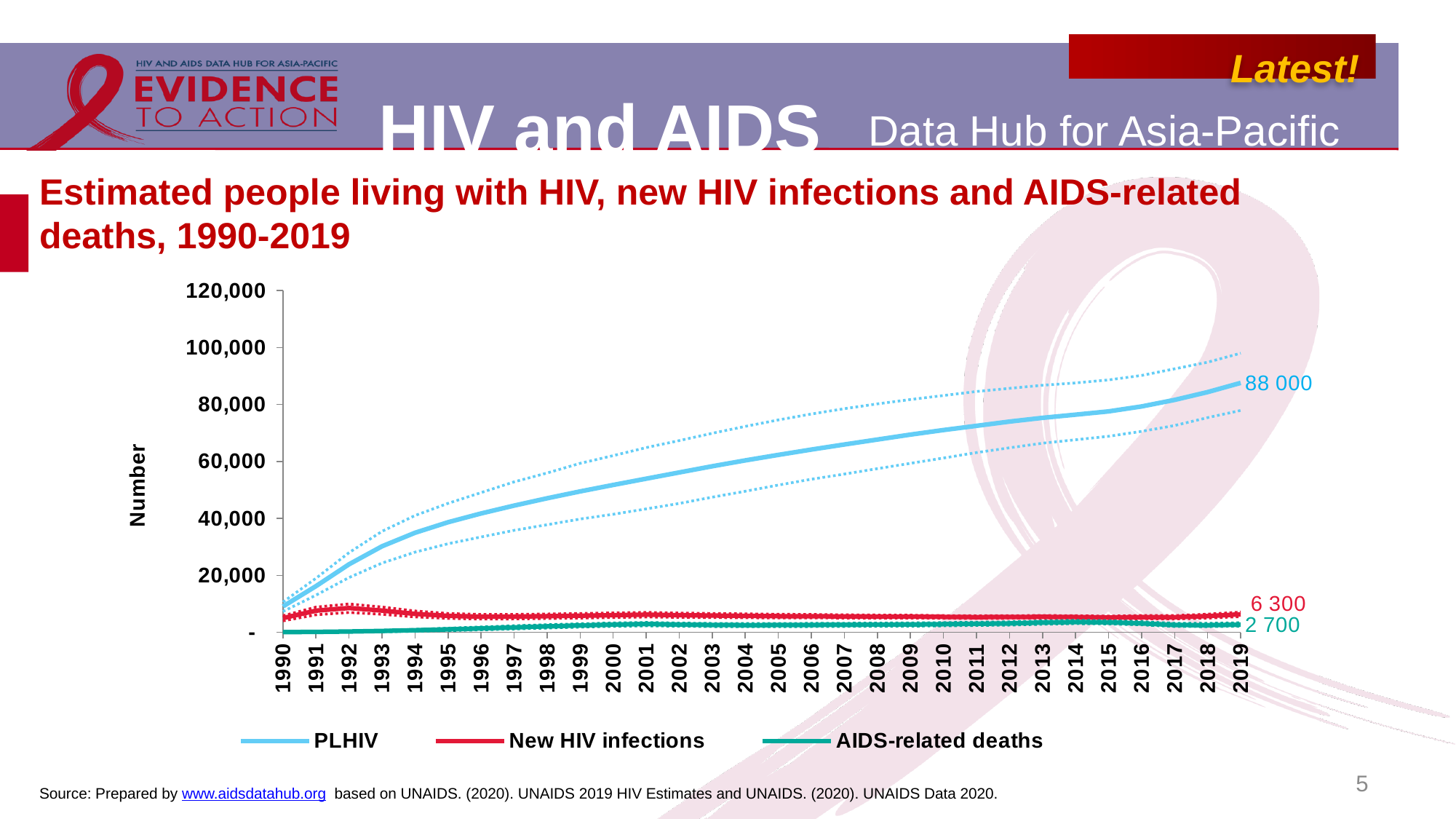
How many years are shown on the x axis? 30 What is the value for AIDS-related deaths in 2019? 2 700 What is the value for PLHIV in 2019? 88 000 Is the value for PLHIV in 1995 greater or less than 60,000? less What kind of chart is shown on the slide? line chart Is the value for PLHIV in 2000 greater or less than 40,000? greater Does the PLHIV line rise or fall from 1990 to 2019? rise Which series has the lowest value in 2019? AIDS-related deaths Which series has the highest value in 2019? PLHIV What is the value for New HIV infections in 2019? 6 300 What is the difference between the 2019 values for New HIV infections and AIDS-related deaths? 3 600 How many series does the legend list? 3